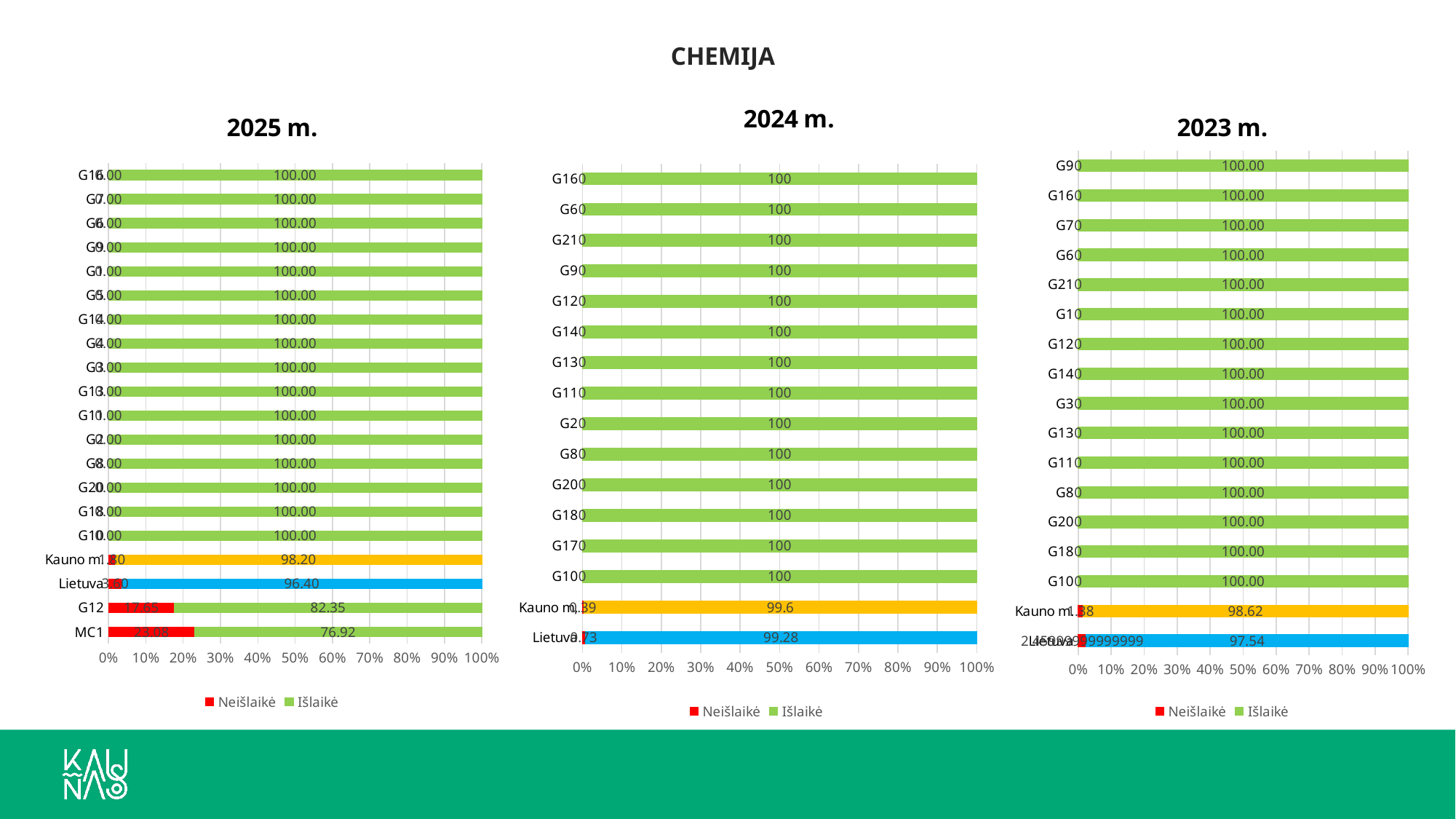
In the 2025 m. chart, which has the larger Neišlaikė value, G12 or MC1? MC1 In the 2023 m. chart, what is the Išlaikė value for Kauno m.? 98.62 What kind of chart is the 2023 m. chart? Stacked bar chart How many series does the legend of the 2024 m. chart list? 2 In the 2024 m. chart, what is the Išlaikė value for Lietuva? 99.28 In the 2025 m. chart, what is the total of the stacked bar for G12? 100 In the 2025 m. chart, which category has the lowest Išlaikė value? MC1 In the 2023 m. chart, what is the Išlaikė value for Lietuva? 97.54 In the 2025 m. chart, what is the Išlaikė value for G12? 82.35 In the 2025 m. chart, what is the difference between the Išlaikė values for G12 and MC1? 5.43 In the 2025 m. chart, what is the Neišlaikė value for MC1? 23.08 In the 2025 m. chart, what is the Išlaikė value for Kauno m.? 98.20